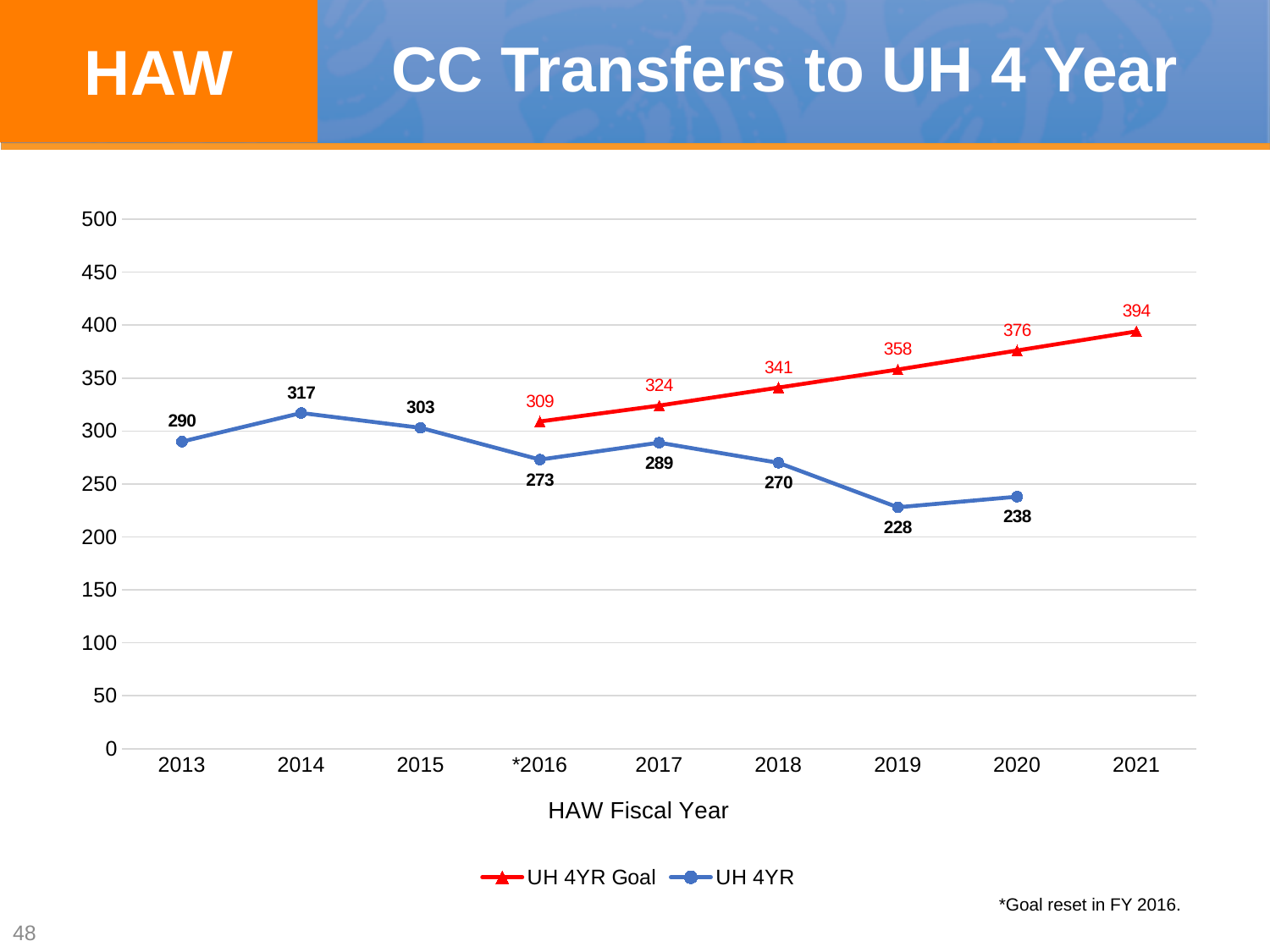
How many fiscal years are shown on the x axis? 9 Which year has the lowest UH 4YR value? 2019 How many series does the legend list? 2 Which is larger in 2017, the UH 4YR Goal or the UH 4YR value? UH 4YR Goal What is the difference between the UH 4YR Goal and the UH 4YR value in 2020? 138 Is the UH 4YR Goal value for 2019 greater or less than 350? greater What kind of chart is shown on the slide? Line chart Which year has the highest UH 4YR value? 2014 What is the UH 4YR value for 2014? 317 What is the UH 4YR value for 2019? 228 Does the UH 4YR Goal series rise or fall from *2016 to 2021? Rise What is the UH 4YR Goal value for 2021? 394